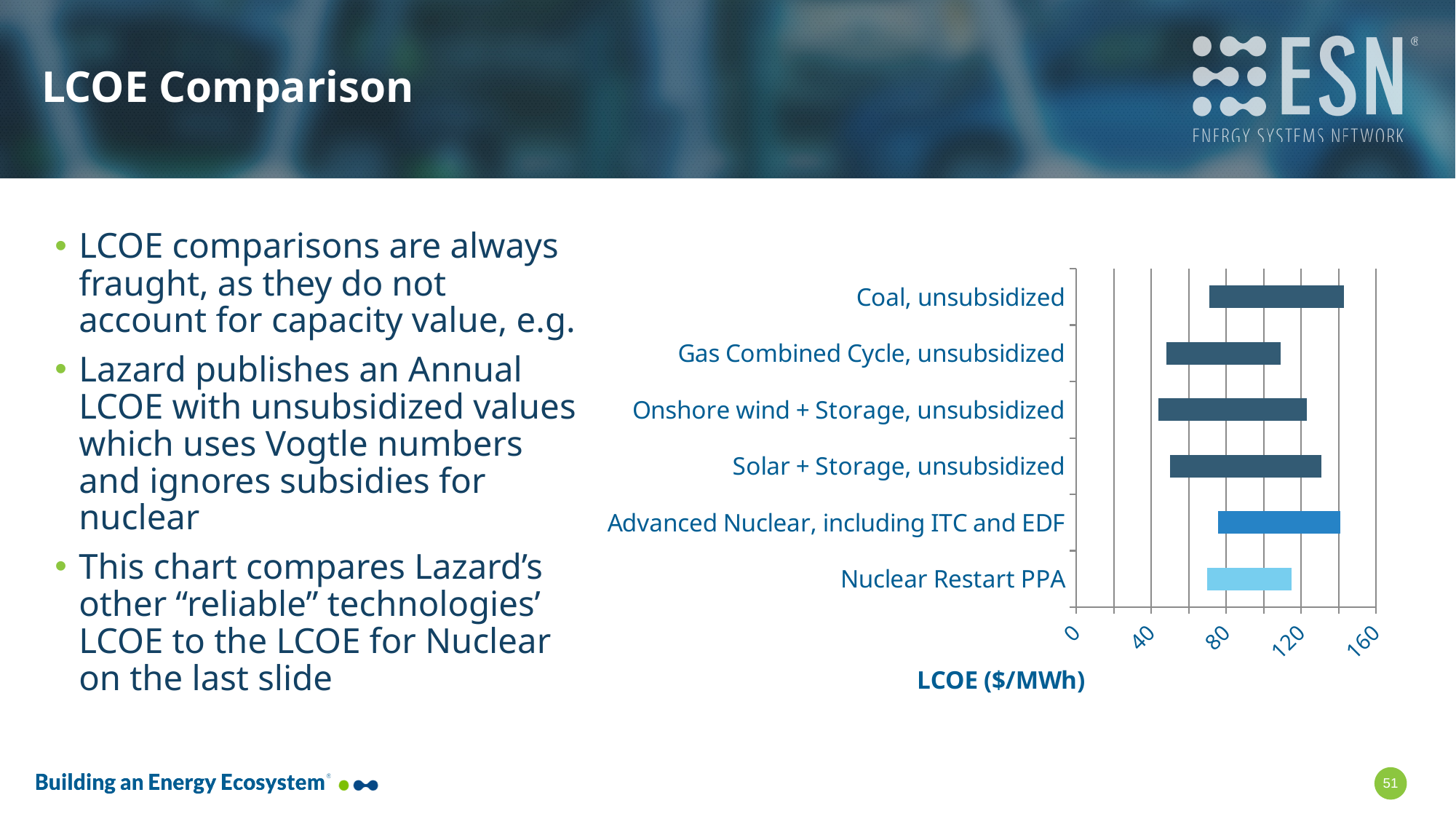
Is the lower end of the bar for Onshore wind + Storage, unsubsidized greater or less than 80? less Is the upper end of the bar for Solar + Storage, unsubsidized greater or less than 120? greater Which bar extends further to the right: Coal, unsubsidized or Nuclear Restart PPA? Coal, unsubsidized How many technology categories are plotted on the chart? 6 Is the lower end of the bar for Advanced Nuclear, including ITC and EDF greater or less than 40? greater Which category is drawn with the lightest blue bar? Nuclear Restart PPA What is the title of the horizontal axis of the chart? LCOE ($/MWh) Which bar starts further to the left: Gas Combined Cycle, unsubsidized or Advanced Nuclear, including ITC and EDF? Gas Combined Cycle, unsubsidized What kind of chart is shown on the slide? Bar chart